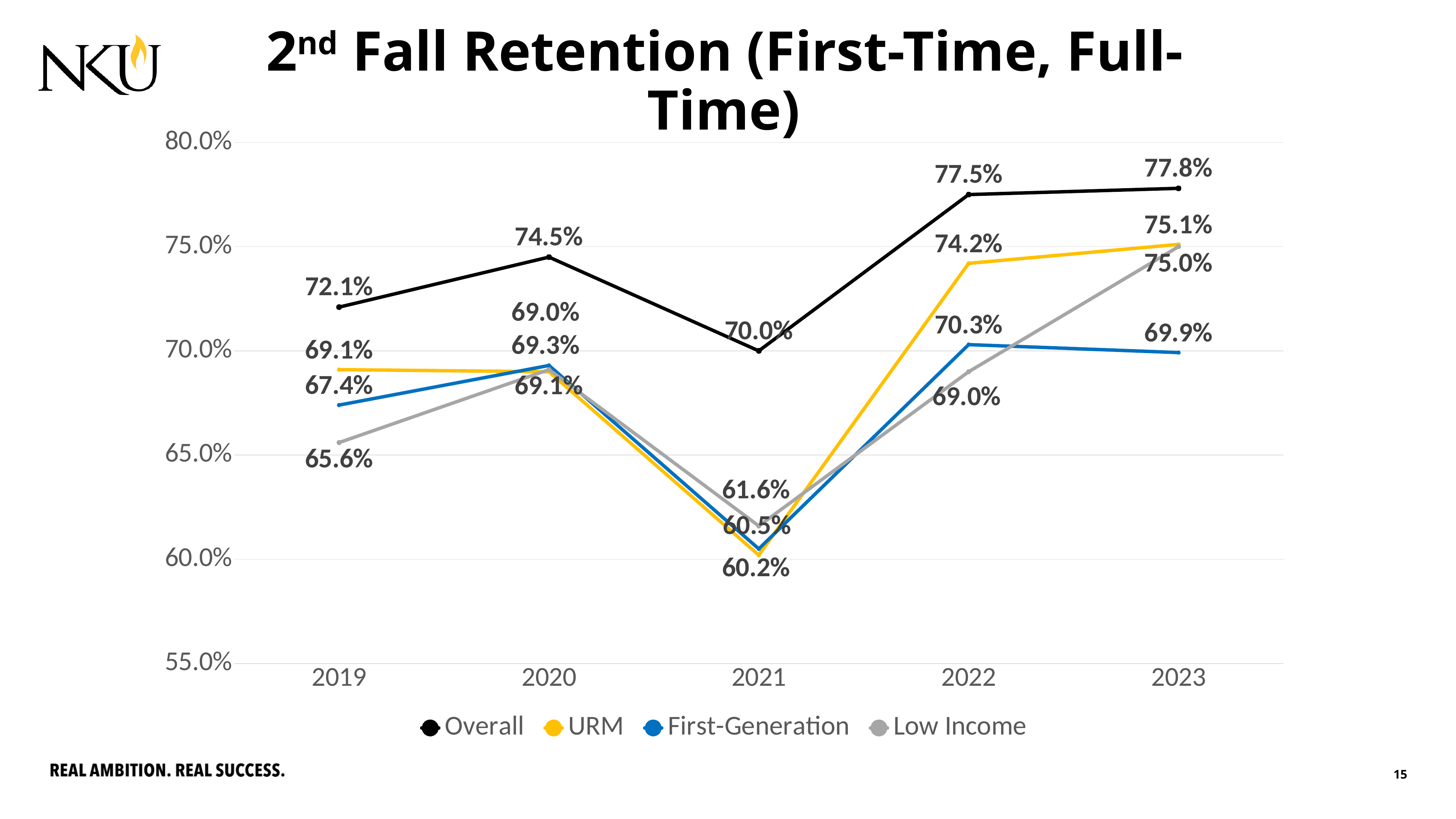
Is the Low Income retention rate for 2020 greater or less than 70.0%? less What is the Overall 2nd fall retention rate for 2023? 77.8% What is the URM retention rate for 2022? 74.2% What is the Overall retention rate for 2021? 70.0% What is the Low Income retention rate for 2019? 65.6% In which year is the Overall retention rate highest? 2023 What is the First-Generation retention rate for 2023? 69.9% In which year is the Overall retention rate lowest? 2021 In 2023, which is higher: the URM rate or the First-Generation rate? URM What kind of chart is shown on the slide? Line chart By how many percentage points did the Overall retention rate change from 2021 to 2022? 7.5 percentage points How many series does the legend list? 4